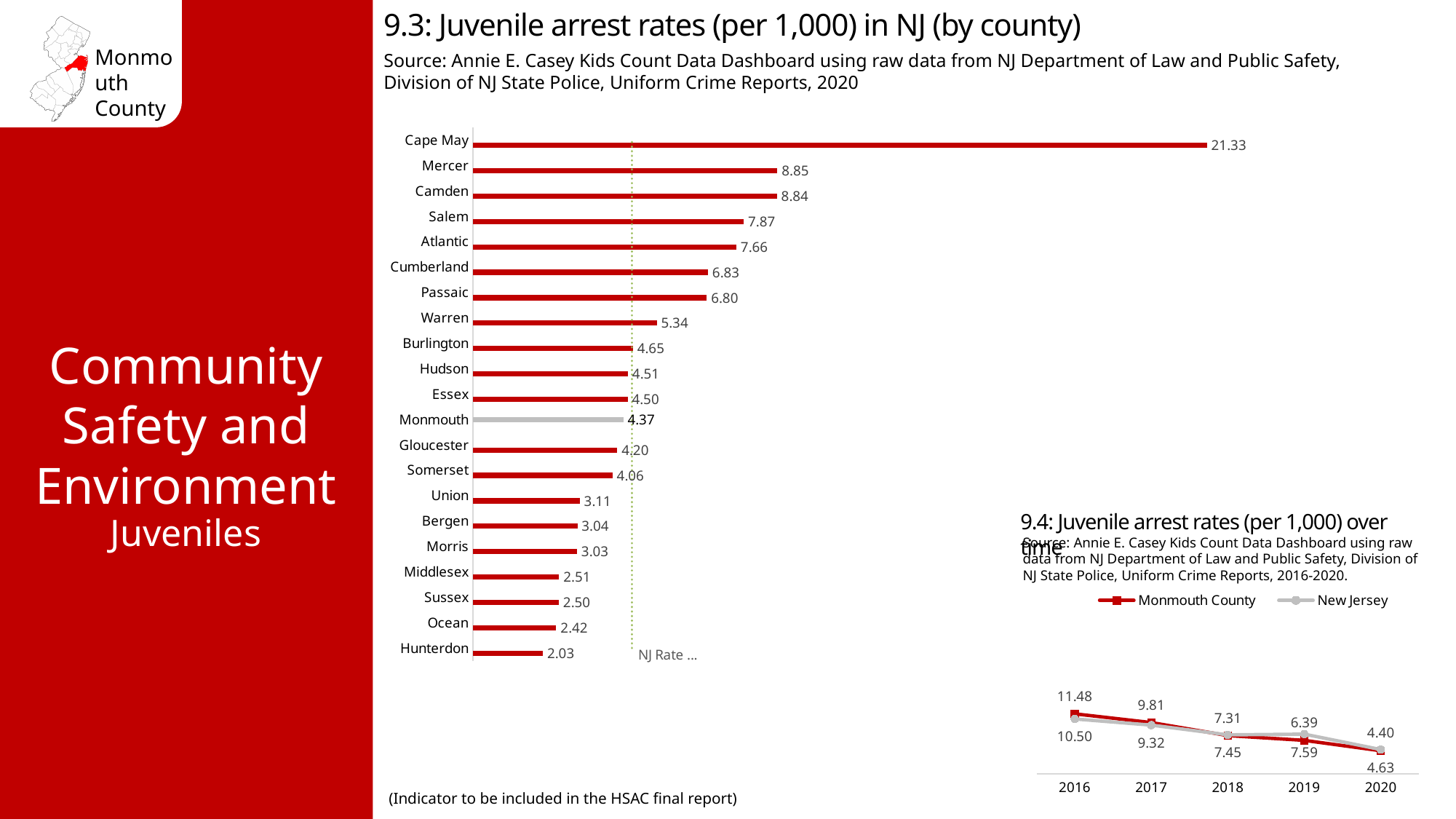
In chart 9.4 (juvenile arrest rates over time), what is the Monmouth County rate in 2016? 11.48 In chart 9.3 (juvenile arrest rates by county), which has a higher rate, Warren or Burlington? Warren In chart 9.4 (juvenile arrest rates over time), how many years are plotted on the x axis? 5 In chart 9.4 (juvenile arrest rates over time), how many series does the legend list? 2 What kind of chart is chart 9.3 (juvenile arrest rates by county)? Bar chart In chart 9.3 (juvenile arrest rates by county), what is the rate for Monmouth? 4.37 In chart 9.3 (juvenile arrest rates by county), what is the difference between Cape May's rate and Mercer's rate? 12.48 In chart 9.3 (juvenile arrest rates by county), which county has the lowest rate? Hunterdon In chart 9.3 (juvenile arrest rates by county), what is the rate for Passaic? 6.80 In chart 9.4 (juvenile arrest rates over time), do the values rise or fall from 2016 to 2020? Fall In chart 9.3 (juvenile arrest rates by county), which county has the highest rate? Cape May In chart 9.3 (juvenile arrest rates by county), how many counties are shown? 21